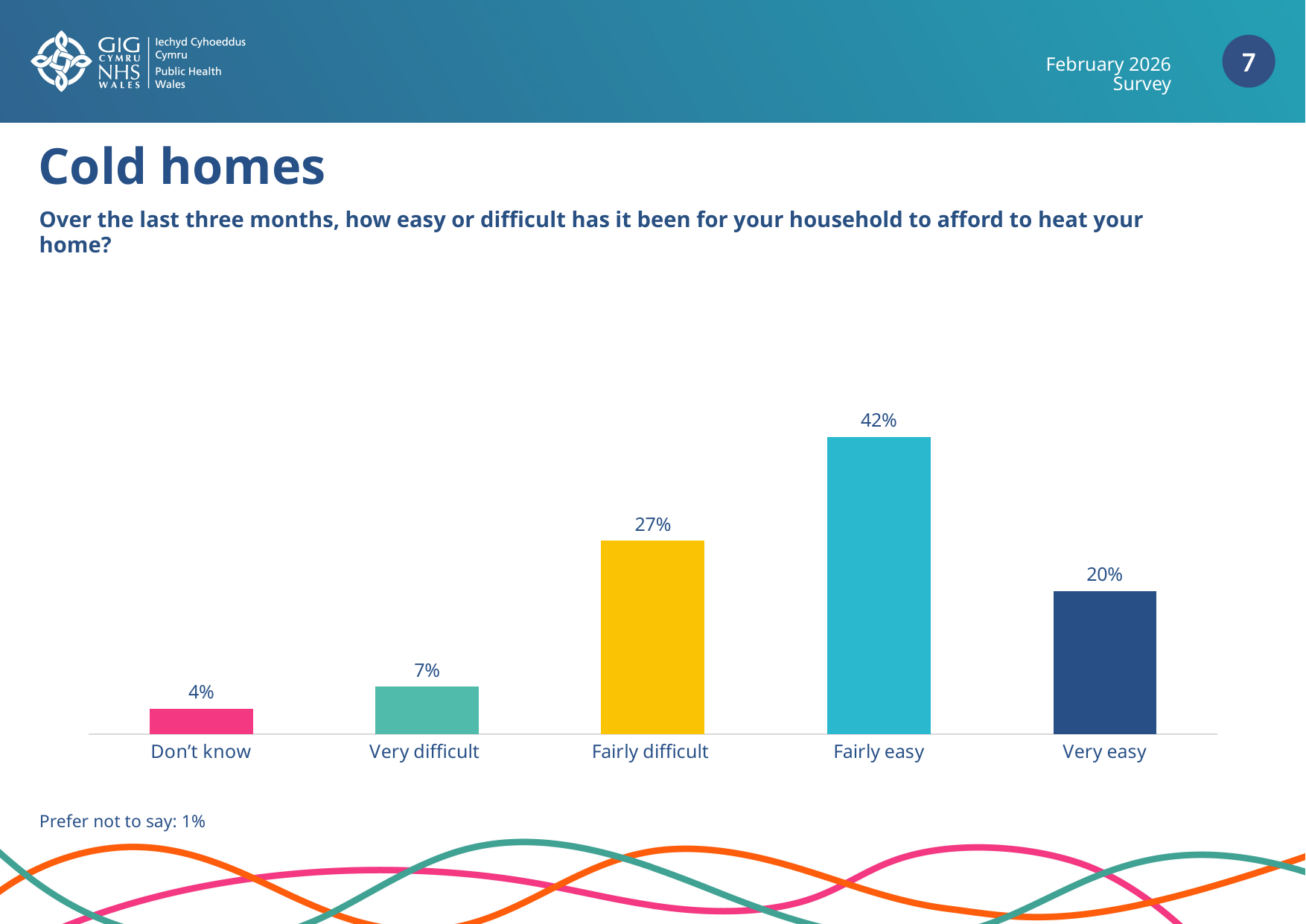
What percentage of respondents said it was very difficult to afford to heat their home? 7% Which response category has the highest percentage? Fairly easy What percentage is given for 'Prefer not to say' in the note below the chart? 1% What is the difference in percentage points between 'Fairly easy' and 'Fairly difficult'? 15 Which response category has the lowest percentage? Don't know What type of chart is shown on the slide? Bar chart What percentage of respondents said it was fairly easy to afford to heat their home? 42% What percentage of respondents answered 'Don't know'? 4% What is the difference in percentage points between 'Very easy' and 'Very difficult'? 13 Which is larger, the percentage for 'Fairly difficult' or for 'Very easy'? Fairly difficult How many response categories are shown as bars in the chart? 5 What percentage of respondents said it was very easy to afford to heat their home? 20%